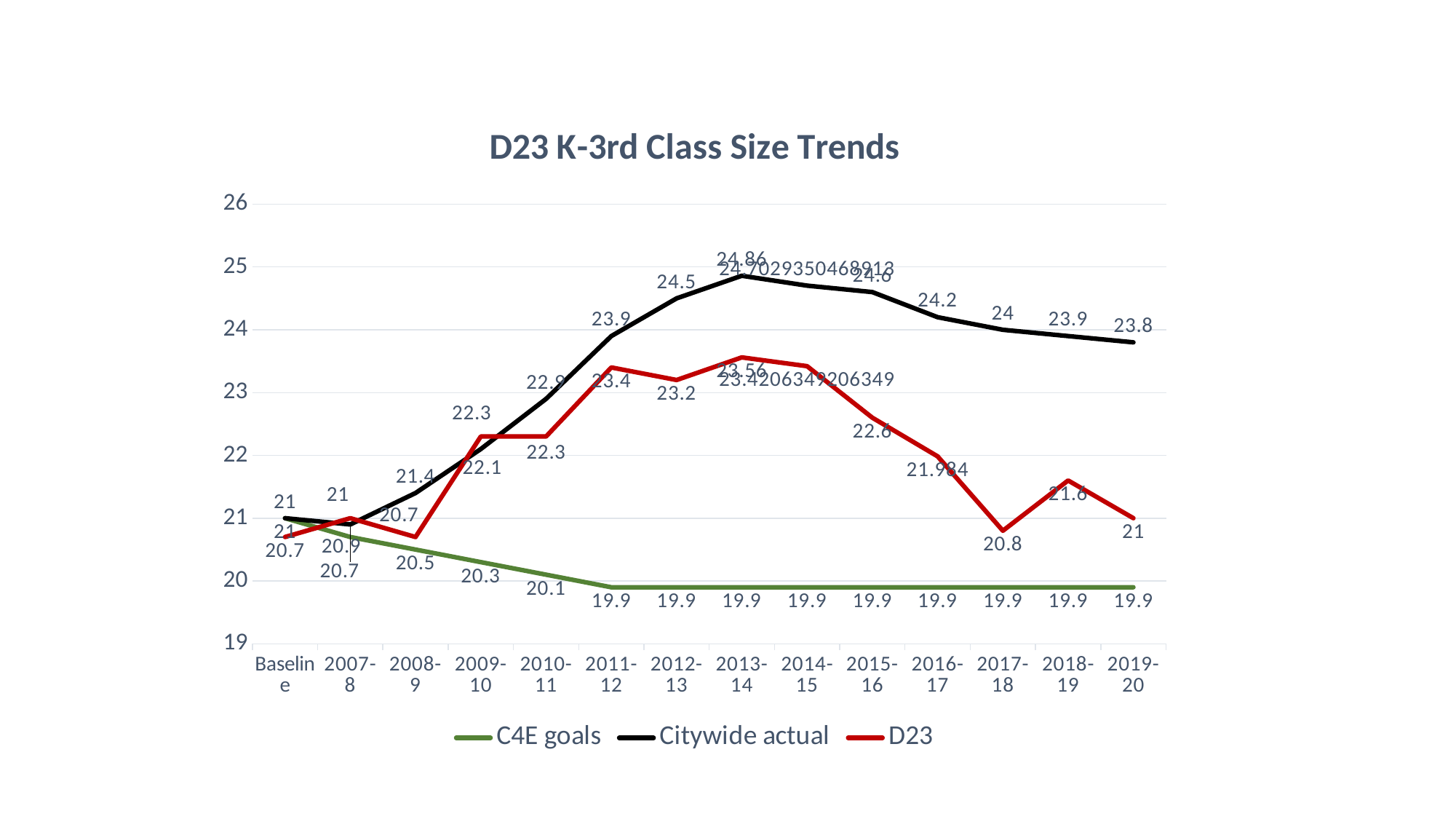
In which year is the D23 value highest? 2013-14 What is the D23 value for 2017-18? 20.8 Is the Citywide actual value for 2014-15 greater or less than 24? greater What kind of chart is shown on the slide? line chart What is the Citywide actual value for 2012-13? 24.5 Do the C4E goals values rise or fall from Baseline to 2011-12? fall What is the C4E goals value for 2019-20? 19.9 What is the difference between the Citywide actual and D23 values for 2019-20? 2.8 In which year is the Citywide actual value highest? 2013-14 Which is larger for 2016-17, Citywide actual or D23? Citywide actual How many categories are shown along the x axis? 14 How many series does the legend list? 3